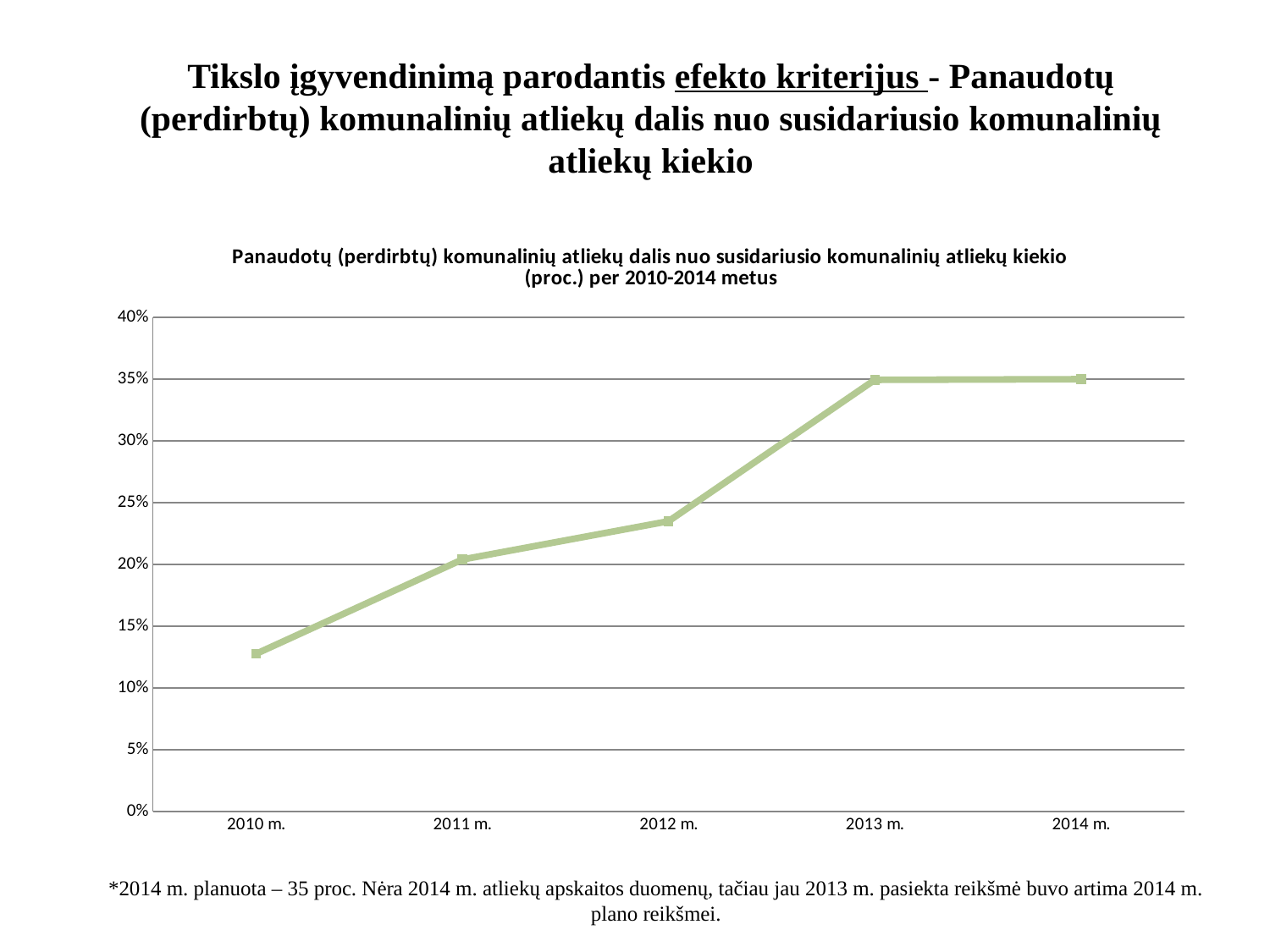
Do the values rise or fall from 2010 m. to 2013 m.? rise Is the value for 2011 m. greater or less than 25%? less Which has the larger value, 2011 m. or 2012 m.? 2012 m. Is the value for 2010 m. greater or less than 10%? greater Is the value for 2010 m. greater or less than 15%? less How many years are plotted on the x axis of the chart? 5 Which year has the lowest value in the chart? 2010 m. What kind of chart is shown on the slide? line chart Which has the larger value, 2010 m. or 2013 m.? 2013 m. What is the value for 2014 m. in the chart? 35%